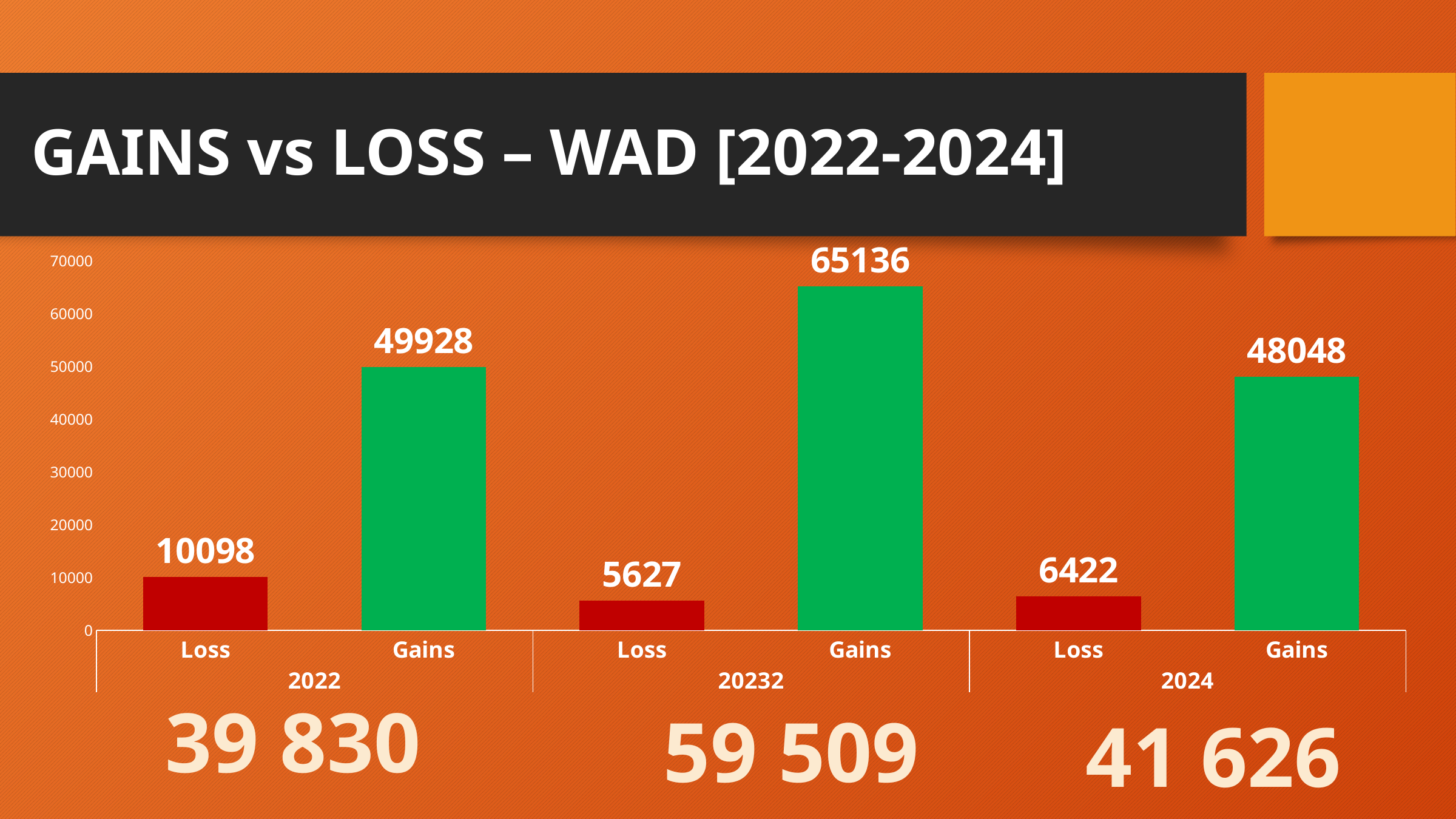
What kind of chart is shown on the slide? Bar chart Which is larger, the Loss for 2022 or the Loss for 2024? Loss for 2022 Which bar has the lowest value on the chart? Loss in 20232 (5627) Is the Gains value for 2024 greater or less than 50000? less What is the difference between Gains and Loss for 2022? 39830 What is the title of the slide containing the chart? GAINS vs LOSS – WAD [2022-2024] What is the value of the Gains bar for 2022? 49928 What is the difference between Gains and Loss for 2024? 41626 Which bar has the highest value on the chart? Gains in 20232 (65136) What is the value of the Loss bar in the group labelled 20232? 5627 How many bars are plotted on the chart? 6 What is the value of the Loss bar for 2024? 6422